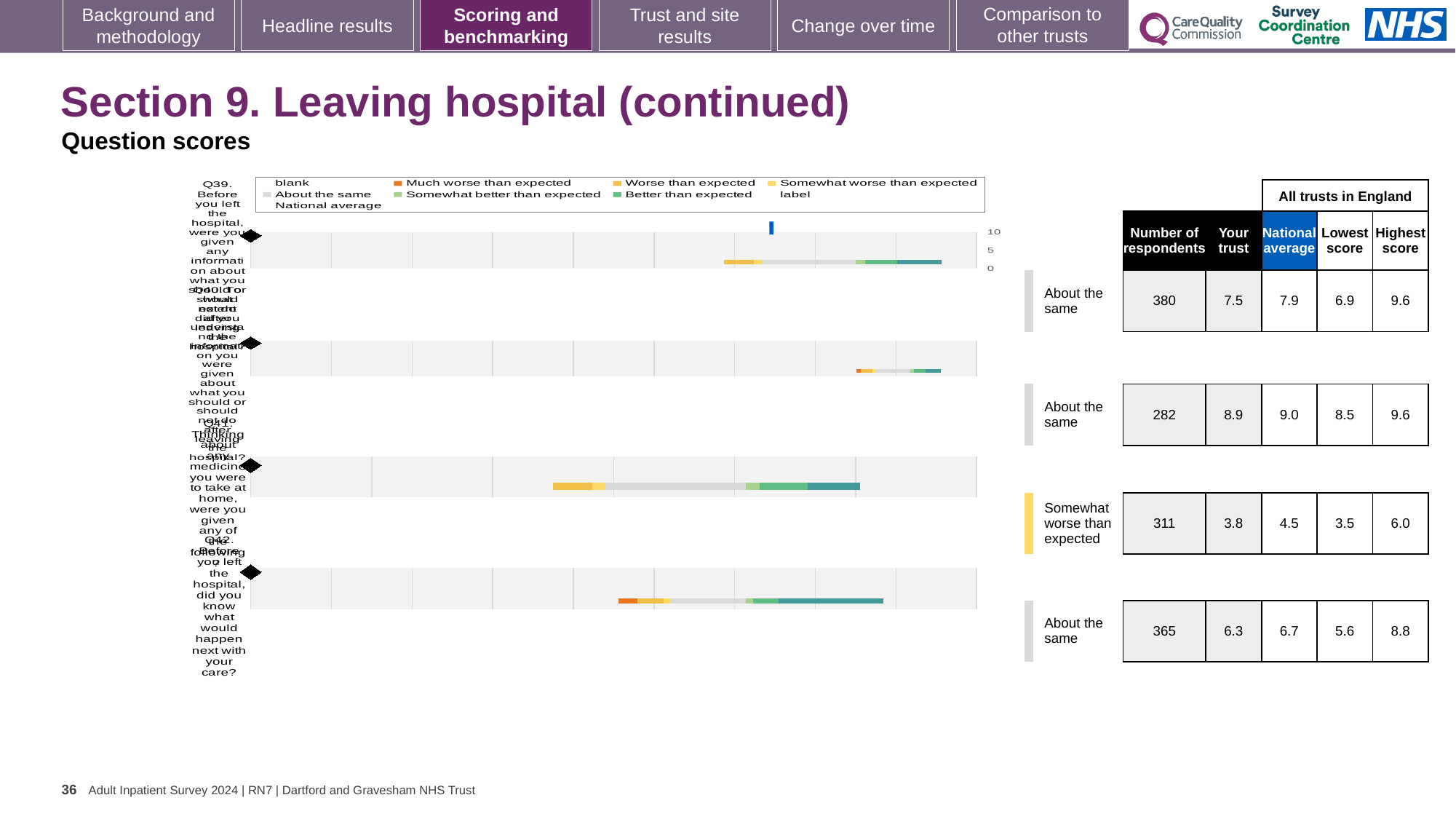
In the table beside the charts, what is the national average for the first question row (Q39)? 7.9 In the table beside the charts, how many respondents are listed for the second question row? 282 Which question row has the lowest 'Your trust' score in the table? the third row (3.8) What kind of chart is used to show the question scores on this slide? bar chart In the table beside the charts, what is the 'Your trust' score for the first question row (Q39)? 7.5 In the table beside the charts, what is the lowest score for the fourth question row (Q42)? 5.6 What benchmark category label is shown for the third question row? Somewhat worse than expected What is the difference between the national average and the 'Your trust' score for the first question row (Q39)? 0.4 How many question rows (charts) are shown on the slide? 4 Which question row has the highest 'Your trust' score in the table? the second row (8.9) For the fourth question row (Q42), which is larger: the 'Your trust' score or the national average? national average In the table beside the charts, what is the highest score for the third question row? 6.0